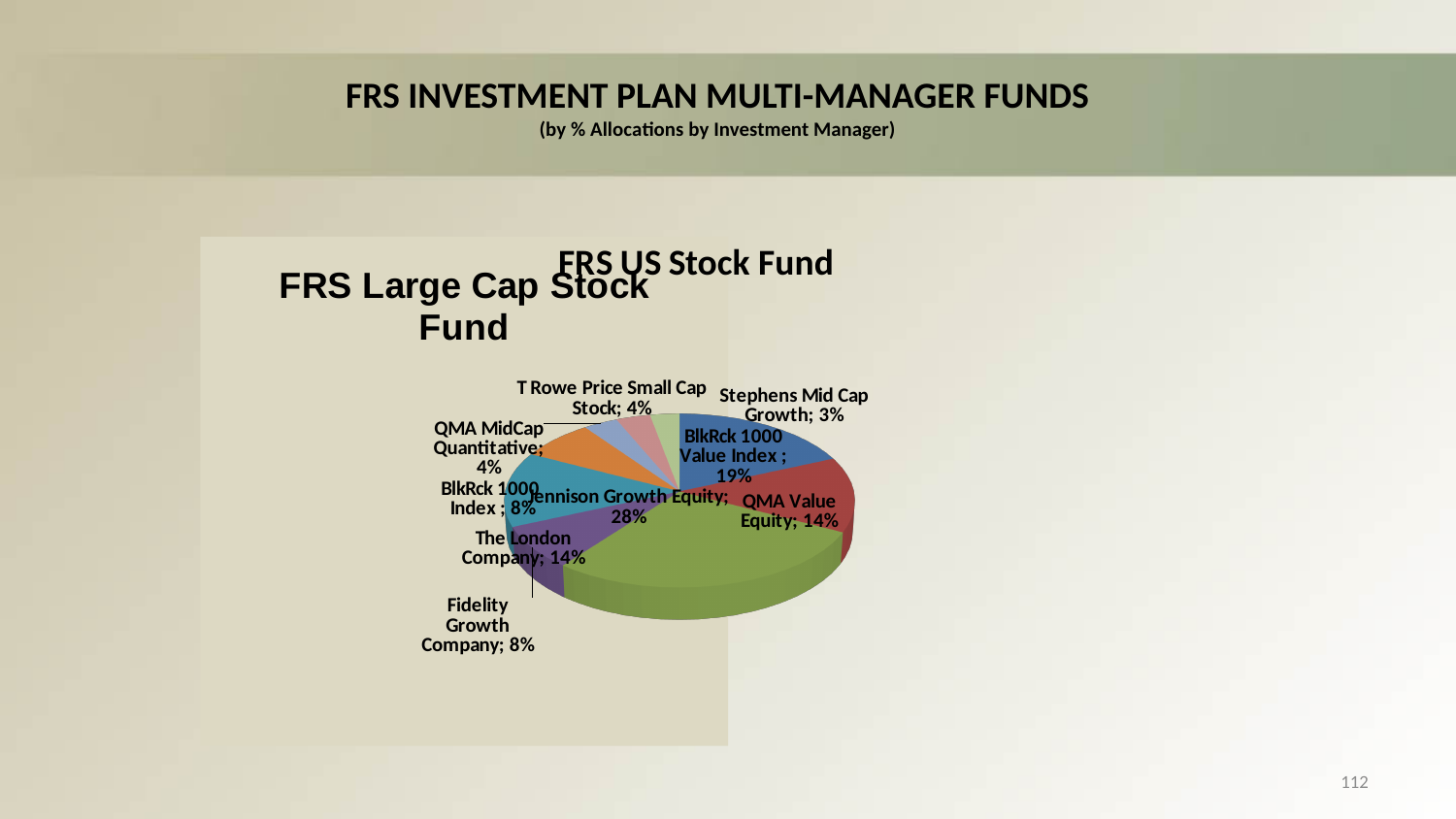
What is the value for Fidelity Growth Company? 8% What is the value for QMA Value Equity? 14% How many slices does the pie chart have? 9 What is the difference between the Jennison Growth Equity share and the BlkRck 1000 Value Index share? 9% Which investment manager has the smallest slice of the pie? Stephens Mid Cap Growth What kind of chart is shown on the slide? pie chart What is the value for T Rowe Price Small Cap Stock? 4% What share of the pie does Jennison Growth Equity hold? 28% What is the value for Stephens Mid Cap Growth? 3% What is the value for BlkRck 1000 Value Index? 19% Which is larger, the share for The London Company or the share for BlkRck 1000 Index? The London Company Which investment manager has the largest slice of the pie? Jennison Growth Equity